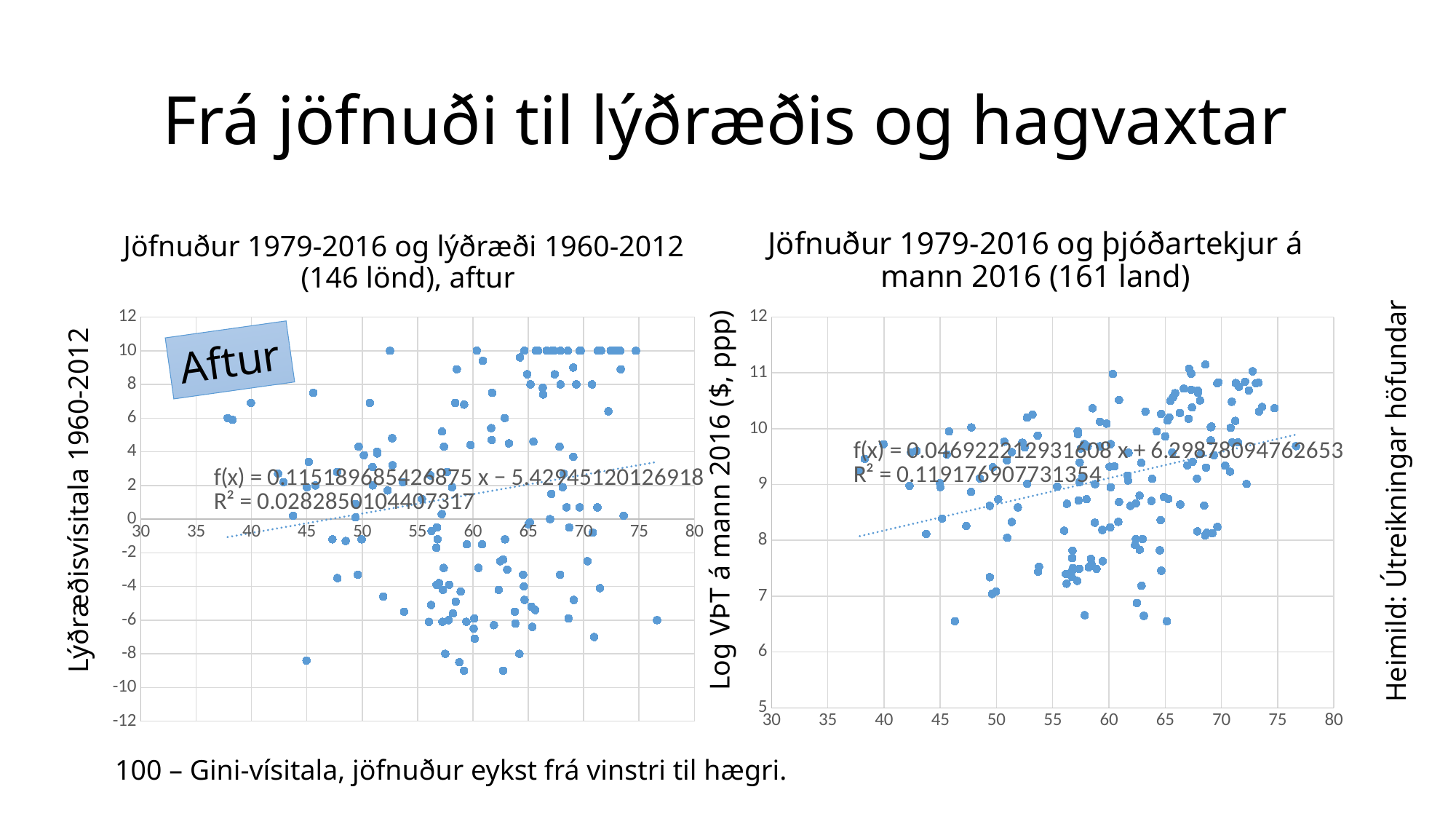
What is the y-axis label of the right chart (þjóðartekjur á mann)? Log VÞT á mann 2016 ($, ppp) What kind of chart is the left chart, titled "Jöfnuður 1979-2016 og lýðræði 1960-2012 (146 lönd), aftur"? Scatter chart What is the y-axis label of the left chart (lýðræði)? Lýðræðisvísitala 1960-2012 In the left chart (lýðræði), does the fitted trendline rise or fall as the x value increases? Rises In the right chart (þjóðartekjur á mann), does the fitted trendline rise or fall as the x value increases? Rises What is the trendline equation shown on the right chart (þjóðartekjur á mann)? f(x) = 0.046922212931608 x + 6.29878094762653 What kind of chart is the right chart, titled "Jöfnuður 1979-2016 og þjóðartekjur á mann 2016 (161 land)"? Scatter chart What is the trendline equation shown on the left chart (lýðræði)? f(x) = 0.115189685426875 x − 5.42945120126918 What is the R² value shown on the left chart (lýðræði)? 0.0282850104407317 Which chart has the higher R² value, the left chart (lýðræði) or the right chart (þjóðartekjur á mann)? The right chart (þjóðartekjur á mann) How many countries does the title of the right chart (þjóðartekjur á mann) say are included? 161 What is the R² value shown on the right chart (þjóðartekjur á mann)? 0.119176907731354